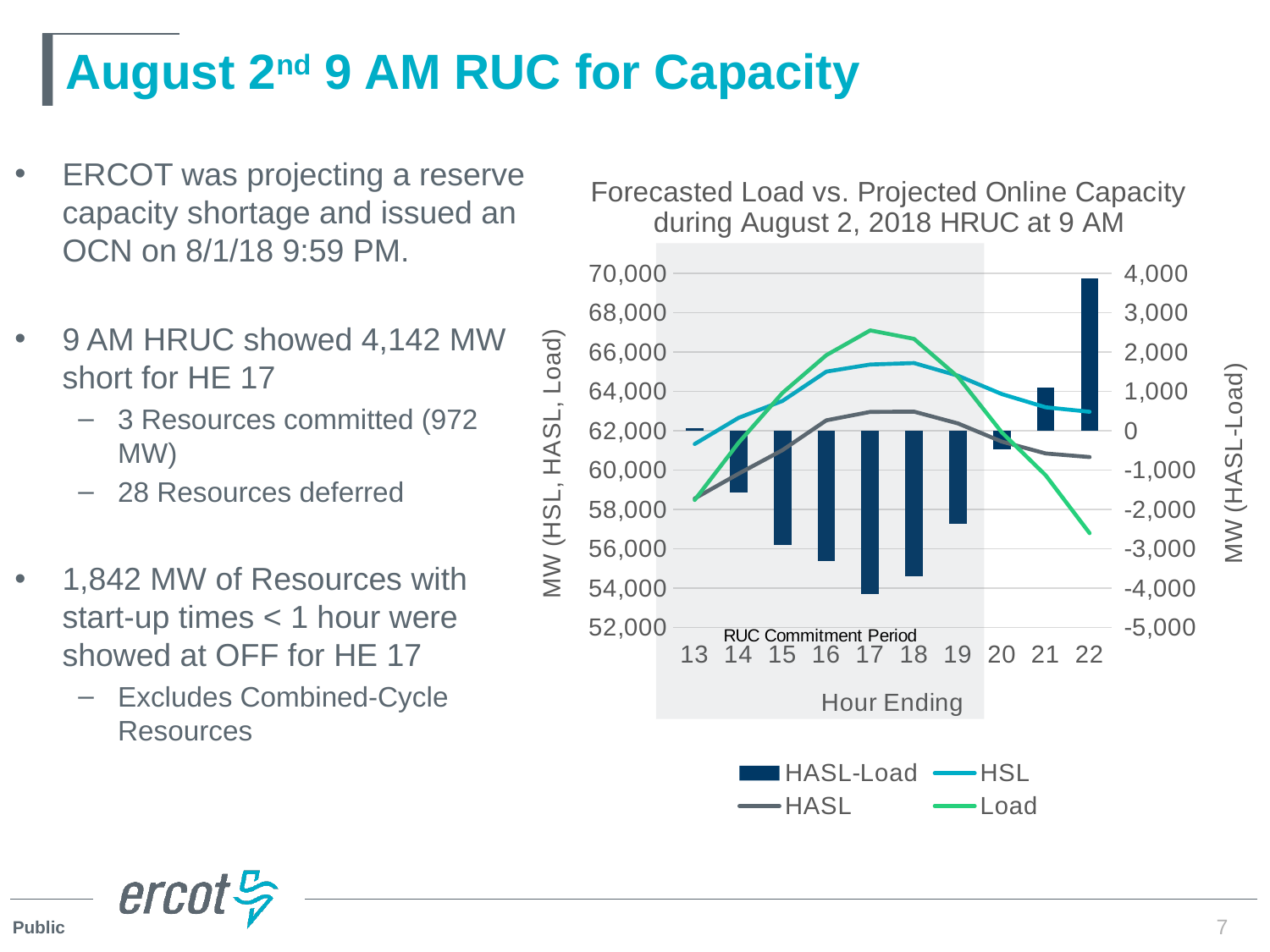
Does the Load line rise or fall from hour ending 18 to hour ending 22? Fall How many hour-ending categories are shown on the x axis? 10 At which hour ending is the HASL-Load bar the lowest (most negative)? 17 Is the HASL-Load value for hour ending 22 greater or less than 3,000? greater What kind of chart is shown on the slide? A combination bar and line chart Which series is plotted as bars in the chart? HASL-Load Is the HASL-Load value for hour ending 17 greater or less than -4,000? less Is the Load value for hour ending 17 greater or less than 66,000? greater At hour ending 17, which is larger, Load or HSL? Load How many series does the chart legend list? 4 At which hour ending is the HASL-Load bar the highest? 22 What is the label of the right-hand vertical axis? MW (HASL-Load)